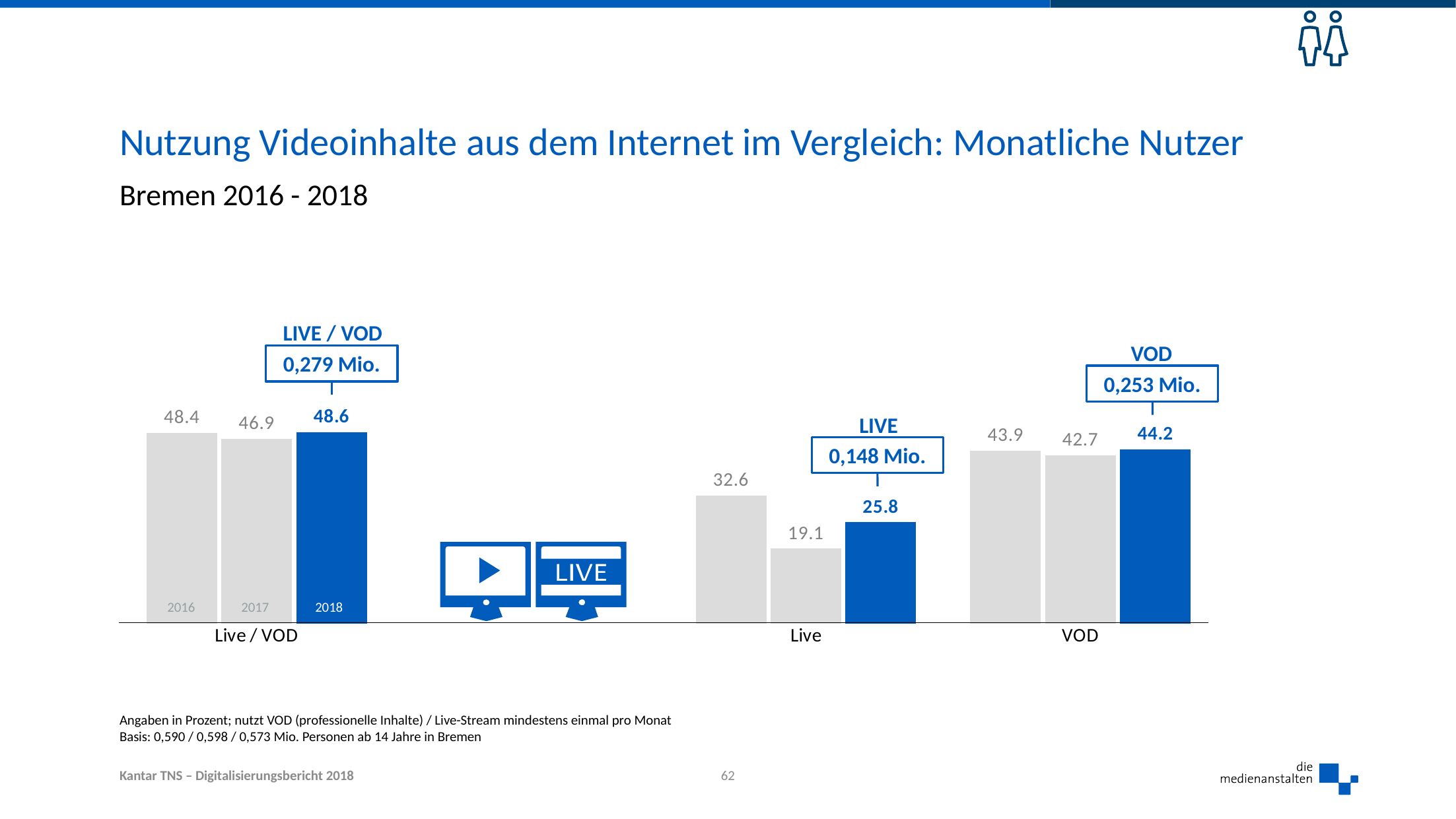
How many monthly users in millions are shown for VOD in 2018? 0,253 Mio. How many years are shown for each category? 3 What is the difference between the VOD values for 2018 and 2017? 1.5 What is the value for Live in 2017? 19.1 What is the value for VOD in 2016? 43.9 What kind of chart is shown on the slide? Bar chart Which year has the lowest value for Live? 2017 What is the difference between the Live values for 2016 and 2017? 13.5 What is the value for Live in 2016? 32.6 Which year has the highest value for VOD? 2018 What is the value for Live / VOD in 2018? 48.6 Which is larger, the Live / VOD value for 2016 or for 2017? 2016